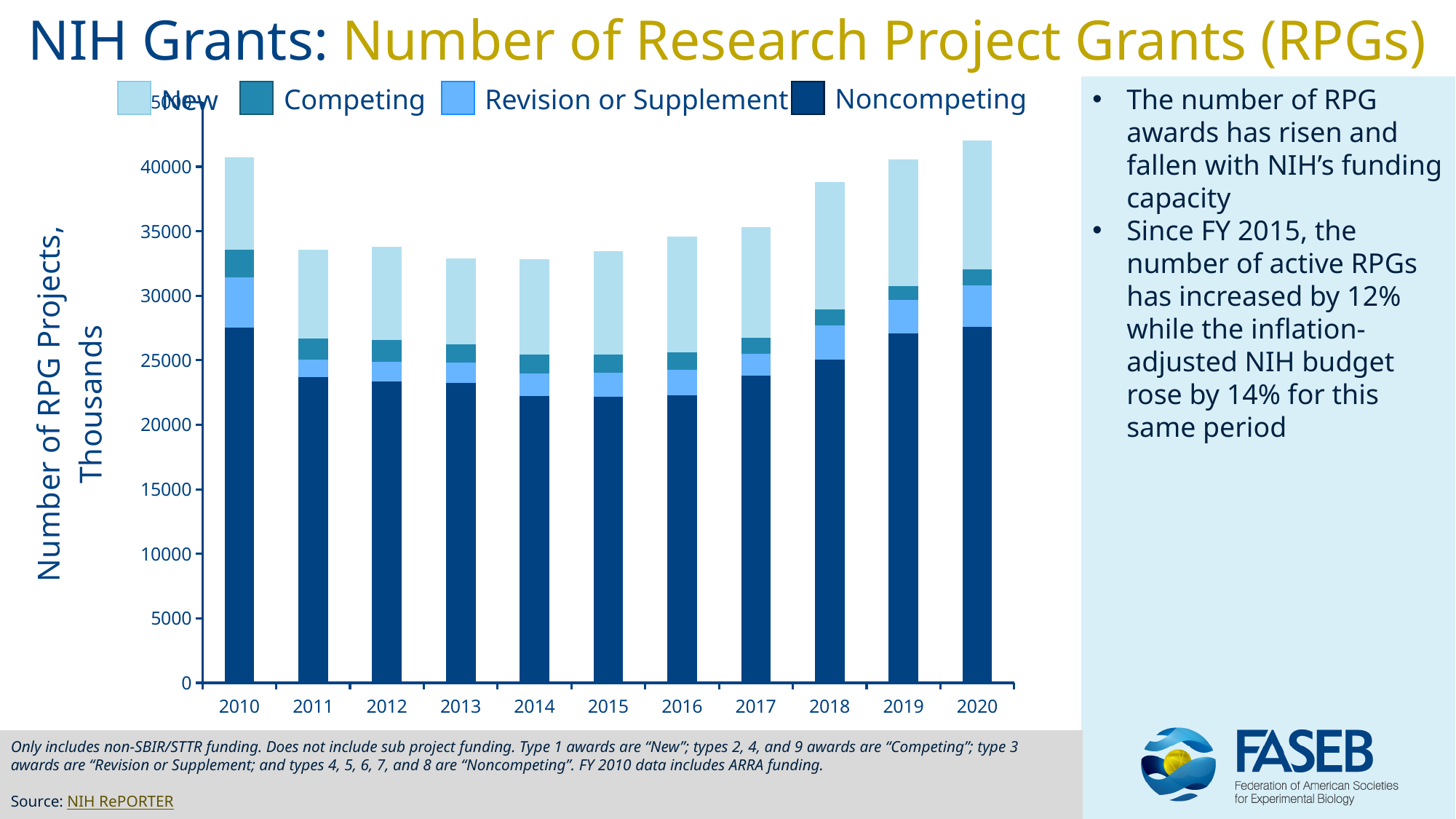
What kind of chart is shown on the slide? Stacked bar chart Which year has the larger total stacked bar, 2015 or 2020? 2020 Is the total stacked bar for 2018 greater or less than 40000? less Do the total stacked bar heights rise or fall from 2015 to 2020? rise Is the total stacked bar for 2013 greater or less than 35000? less Is the Noncompeting value for 2014 greater or less than 25000? less What is the label on the chart's vertical axis? Number of RPG Projects, Thousands Which year has the tallest stacked bar (highest total number of RPG projects)? 2020 How many years are shown along the x axis of the chart? 11 How many series does the chart's legend list? 4